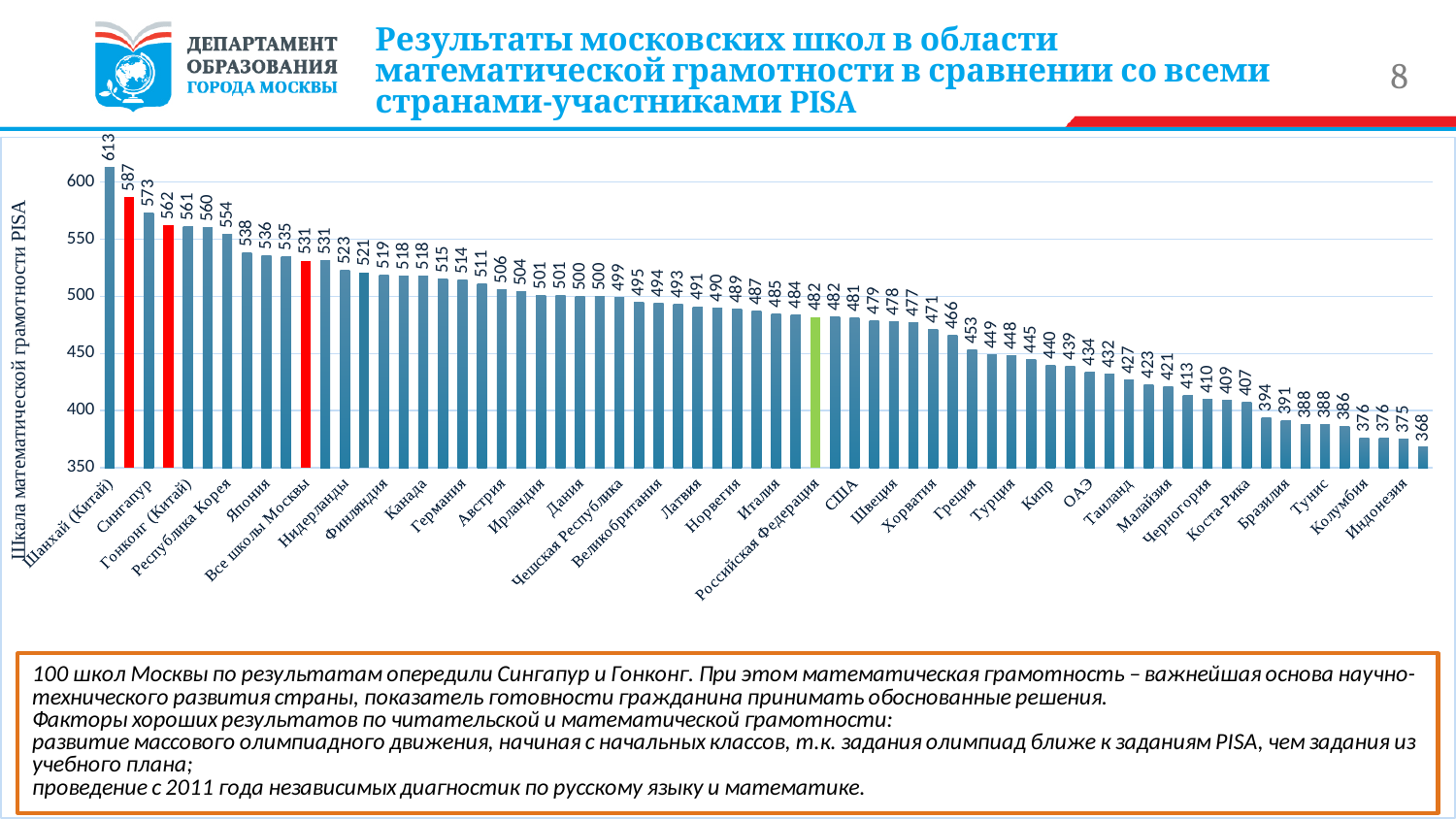
What is the value for Шанхай (Китай)? 613 What is the lowest value shown on the chart? 368 Which is larger, the value for Япония or the value for Нидерланды? Япония What colour is the bar for Российская Федерация? green Which category has the highest value? Шанхай (Китай) Do the values rise or fall from left to right along the x axis? fall What is the value for Российская Федерация? 482 What is the value for Сингапур? 573 What is the value for Индонезия? 375 What is the value for Все школы Москвы? 531 What kind of chart is shown on the slide? bar chart What is the difference between the values for Сингапур and Все школы Москвы? 42